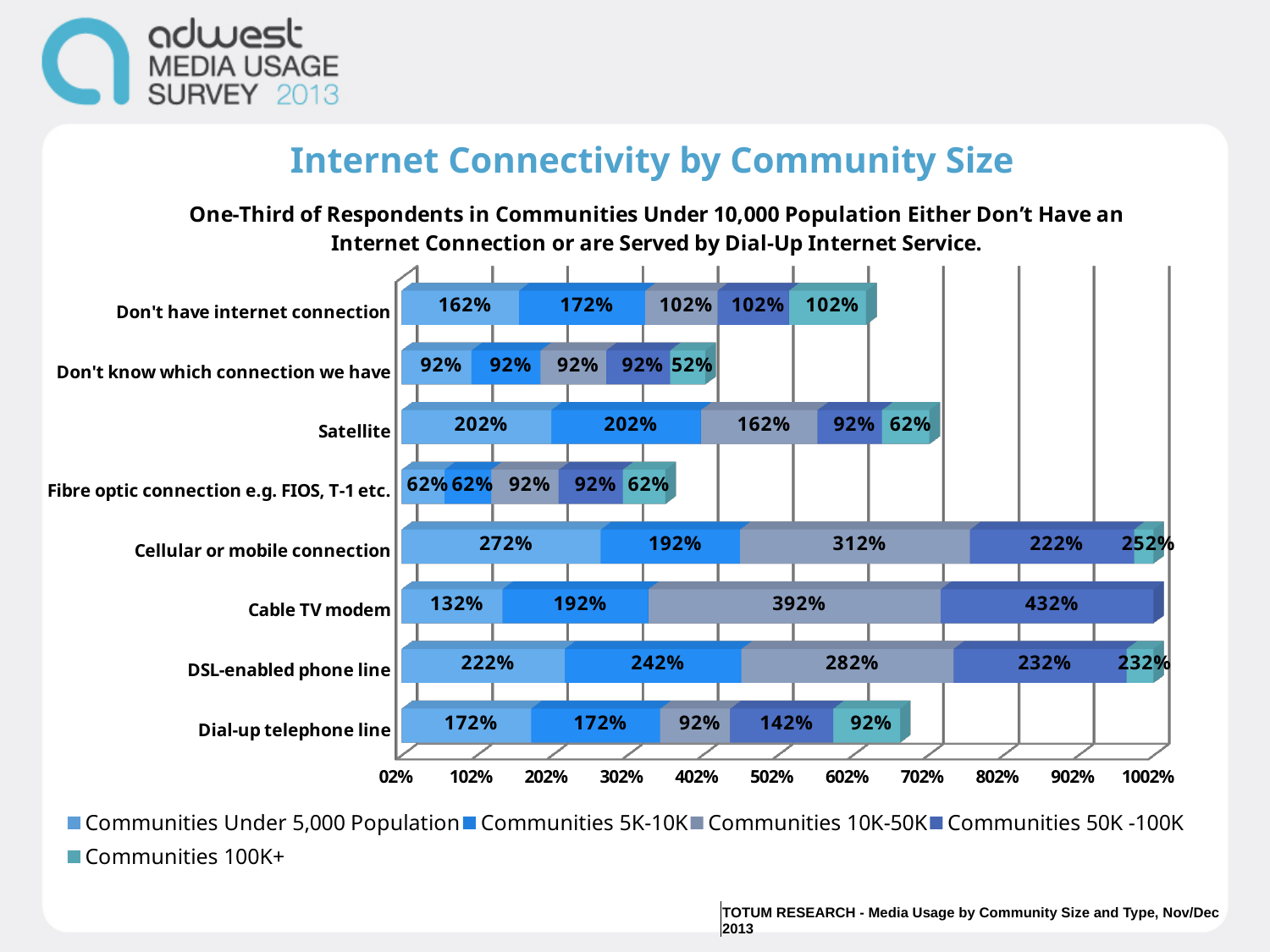
What is the total of the stacked bar for Don't know which connection we have? 420% How many series does the legend list? 5 What is the difference between the Communities 50K -100K value and the Communities 10K-50K value for Cable TV modem? 40% What is the value for Communities 5K-10K for Dial-up telephone line? 172% Which category has the highest value for Communities Under 5,000 Population? Cellular or mobile connection What is the value for Communities Under 5,000 Population for Satellite? 202% Which category has the lowest value for Communities Under 5,000 Population? Fibre optic connection e.g. FIOS, T-1 etc. What kind of chart is shown on the slide? Stacked bar chart What is the value for Communities 100K+ for Cellular or mobile connection? 252% How many connection-type categories are plotted on the chart? 8 What is the value for Communities 10K-50K for Cable TV modem? 392% Which is larger for Communities 10K-50K: Cellular or mobile connection or DSL-enabled phone line? Cellular or mobile connection